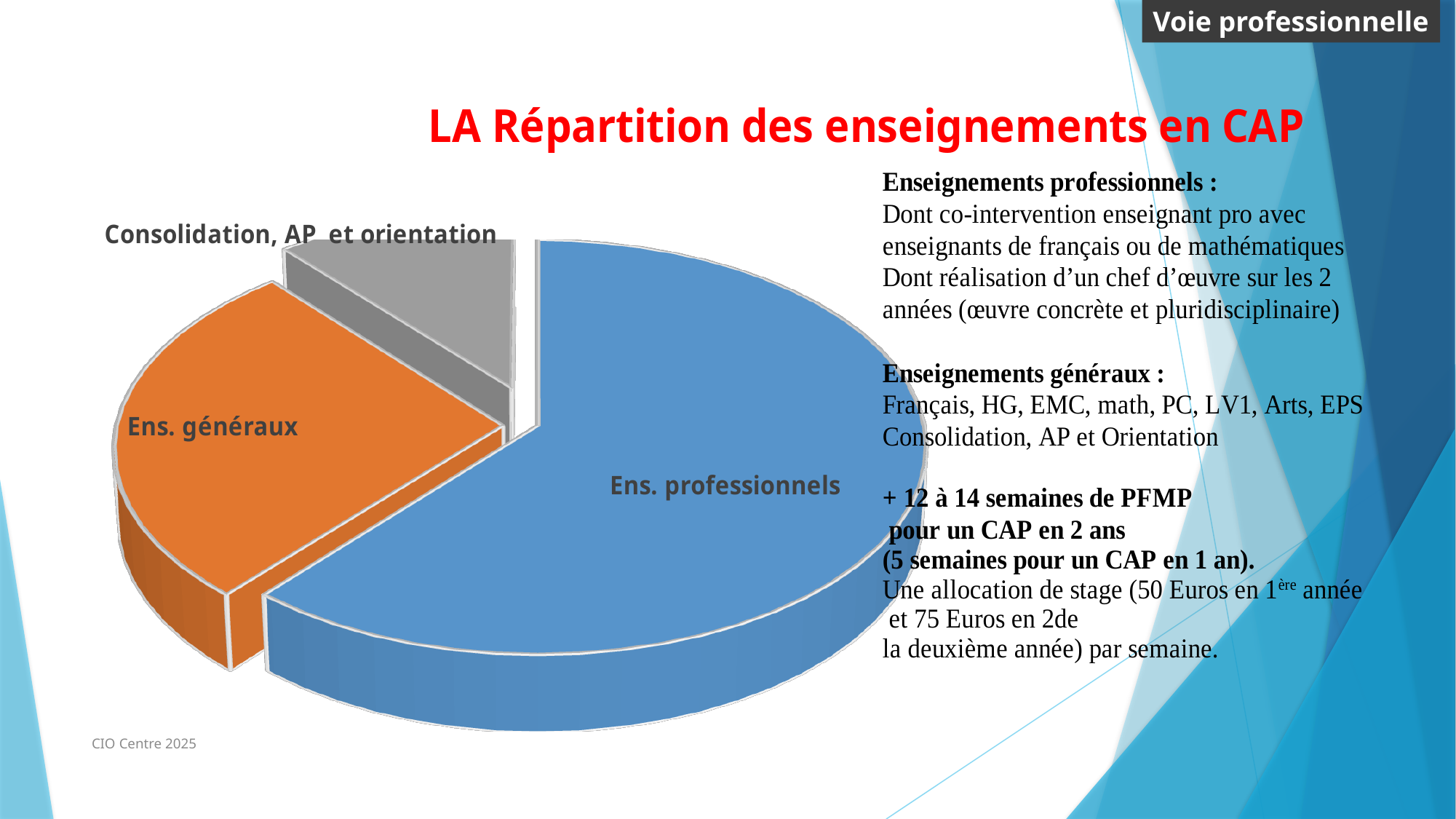
Which slice of the pie chart is the largest? Ens. professionnels What colour is the Ens. généraux slice? orange What colour is the Ens. professionnels slice? blue Which slice is larger, Ens. généraux or Consolidation, AP et orientation? Ens. généraux Does the Ens. professionnels slice take up more or less than half of the pie? more Which slice is larger, Ens. généraux or Ens. professionnels? Ens. professionnels What kind of chart is shown on the slide? pie chart How many slices does the pie chart have? 3 Which slice of the pie chart is the smallest? Consolidation, AP et orientation